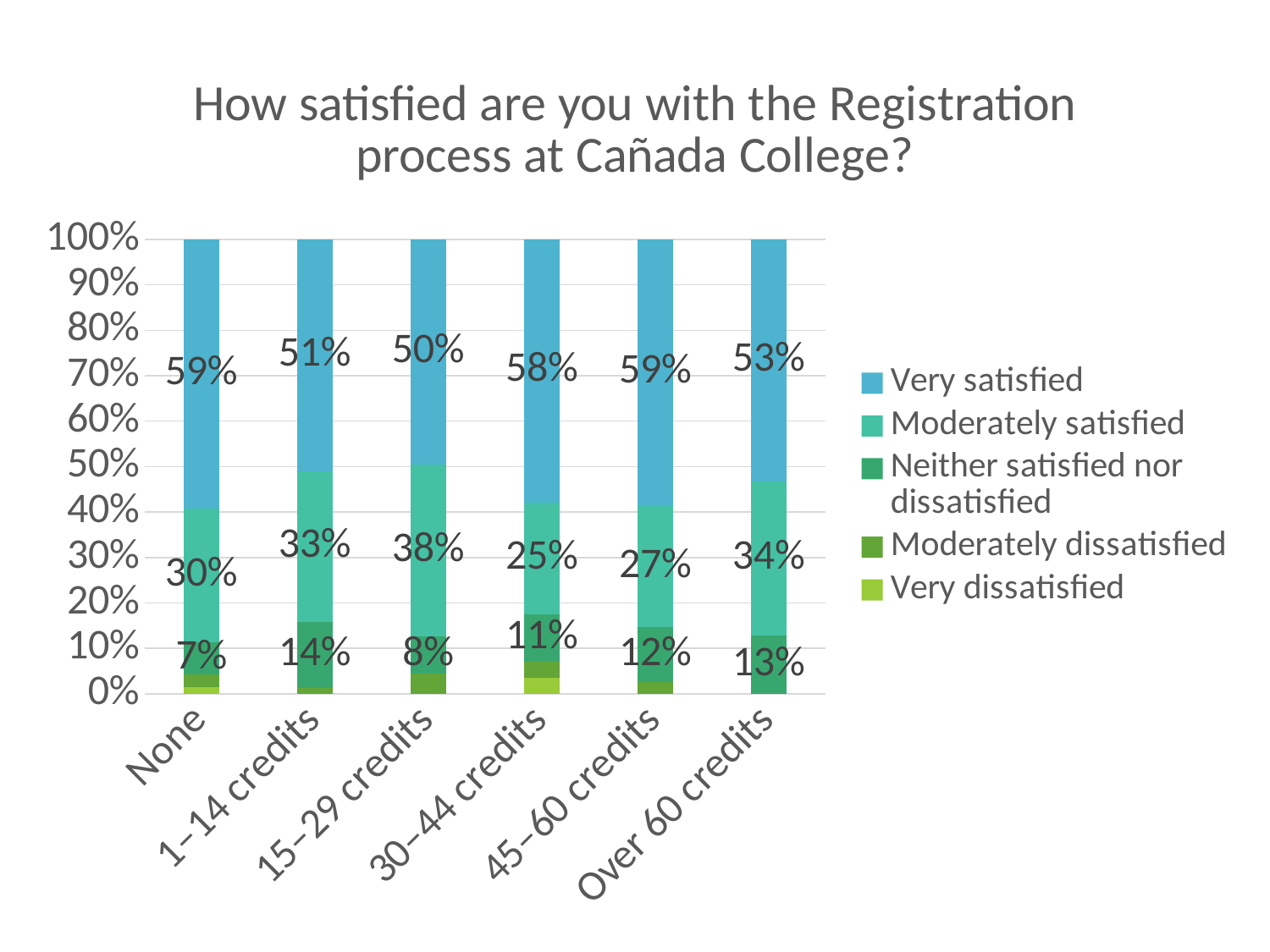
How many series does the legend list? 5 How many credit groups are shown on the x axis? 6 What is the difference between the Very satisfied percentages for 30–44 credits and 1–14 credits? 7% What percentage of respondents with None credits were Moderately satisfied? 30% Which credit group has the lowest Very satisfied percentage? 15–29 credits Which credit group has the lowest Neither satisfied nor dissatisfied percentage? None What percentage of respondents with 1–14 credits were Neither satisfied nor dissatisfied? 14% Which is larger: the Moderately satisfied percentage for 45–60 credits or for Over 60 credits? Over 60 credits What percentage of respondents with Over 60 credits were Very satisfied? 53% What kind of chart is shown on the slide? Stacked bar chart Which credit group has the highest Moderately satisfied percentage? 15–29 credits What percentage of respondents with 15–29 credits were Very satisfied? 50%